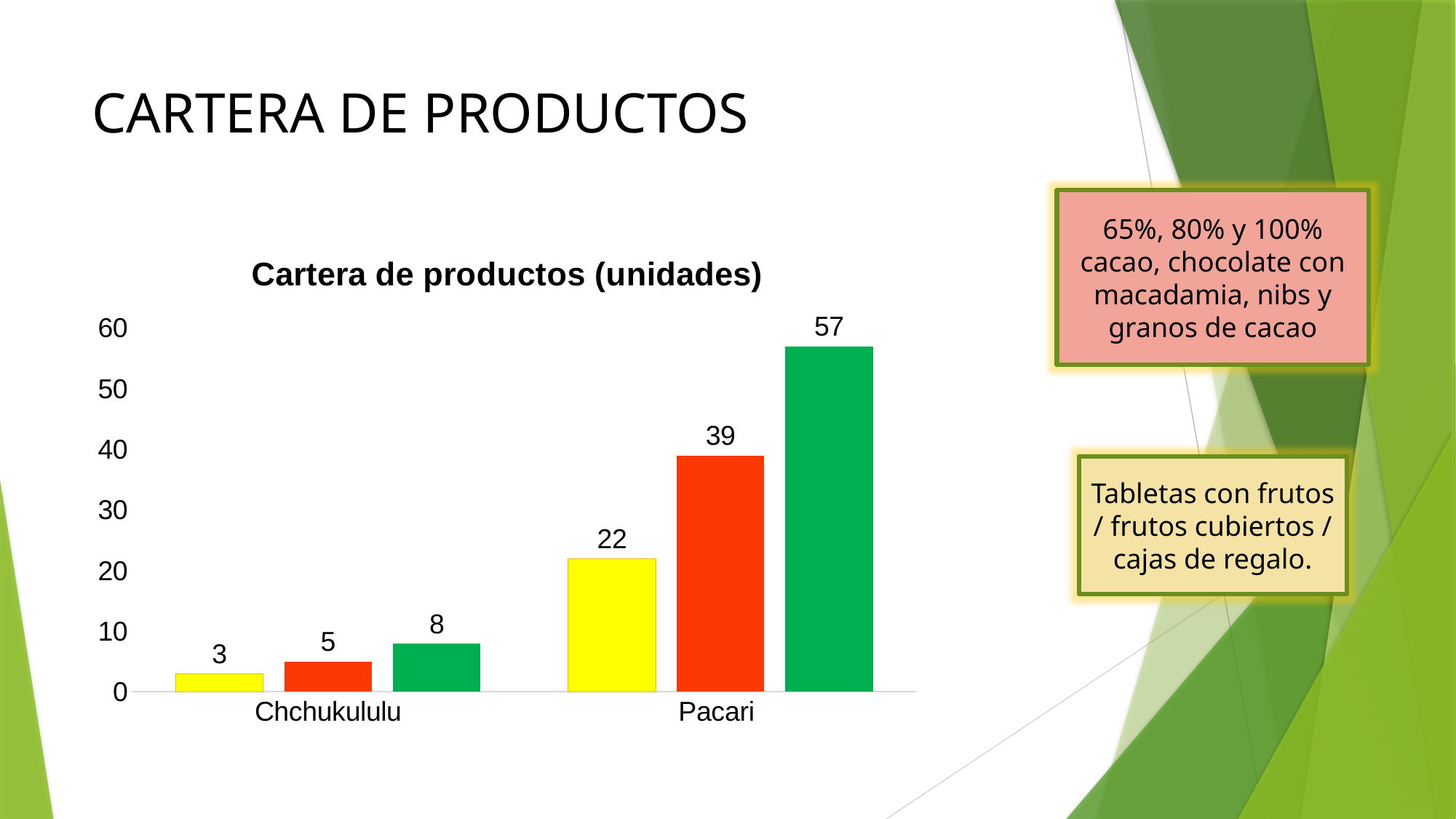
Which bar has the lowest value in the chart? The yellow bar for Chchukululu (3) Which bar has the highest value in the chart? The green bar for Pacari (57) What kind of chart is shown on the slide? Bar chart What is the difference between the green bar for Pacari and the green bar for Chchukululu? 49 What is the title of the chart? Cartera de productos (unidades) What is the value of the green bar for Pacari? 57 What is the value of the green bar for Chchukululu? 8 What is the difference between the red bar and the yellow bar for Pacari? 17 What is the value of the yellow bar for Chchukululu? 3 How many categories are shown on the x axis? 2 Which is larger: the yellow bar for Pacari or the green bar for Chchukululu? The yellow bar for Pacari What is the value of the red bar for Pacari? 39